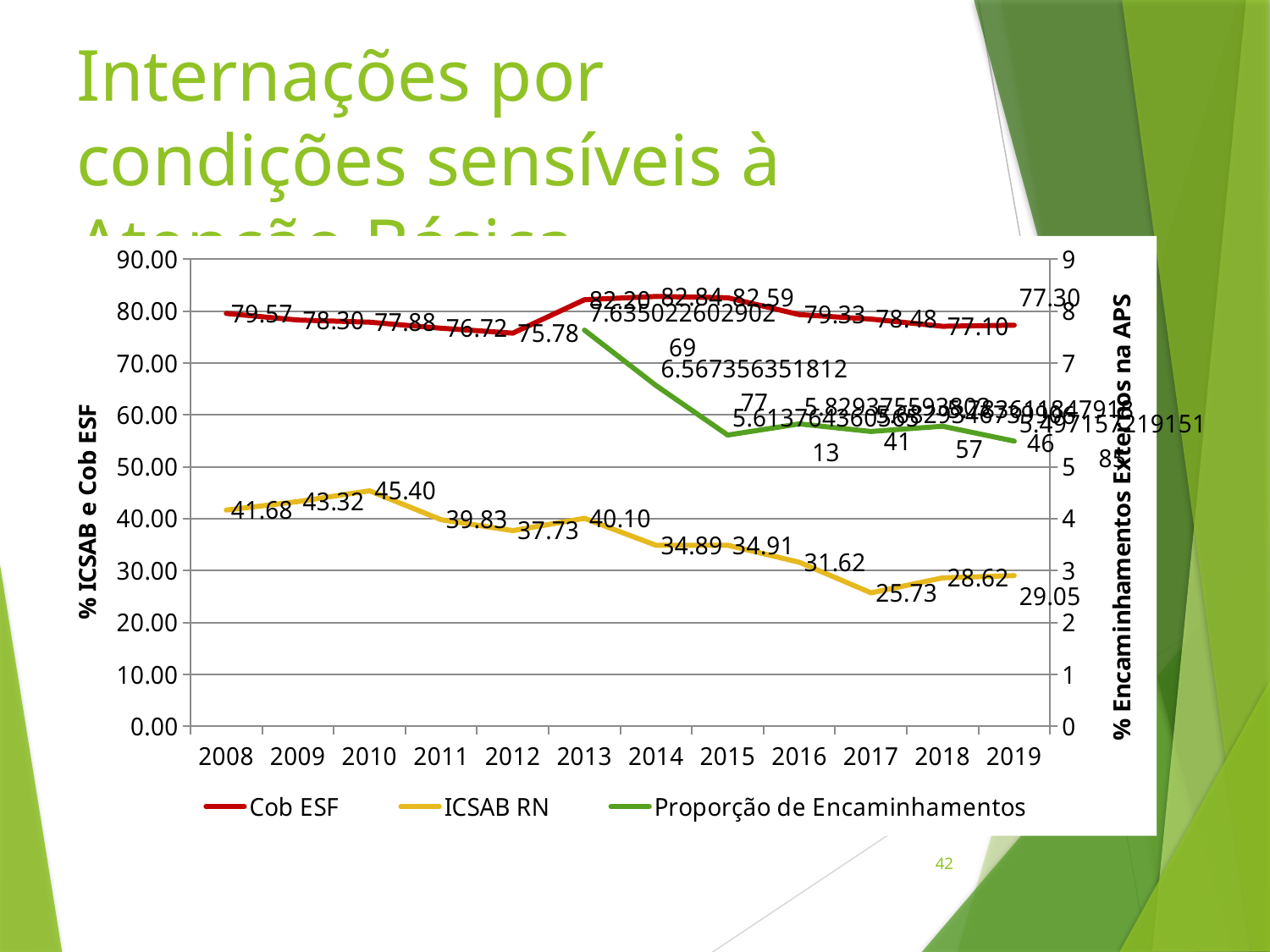
How many years are shown on the x axis? 12 How many series does the legend list? 3 What is the difference between the ICSAB RN values for 2008 and 2019? 12.63 What kind of chart is shown on the slide? Line chart What is the value of Cob ESF in 2019? 77.30 Which year has the higher Cob ESF value, 2013 or 2019? 2013 In which year is ICSAB RN at its lowest? 2017 What is the value of ICSAB RN in 2010? 45.40 What is the value of Cob ESF in 2008? 79.57 In which year is ICSAB RN at its highest? 2010 Is the value of Proporção de Encaminhamentos in 2013 greater or less than 7 on the right-hand axis? greater In which year is Cob ESF at its highest? 2014